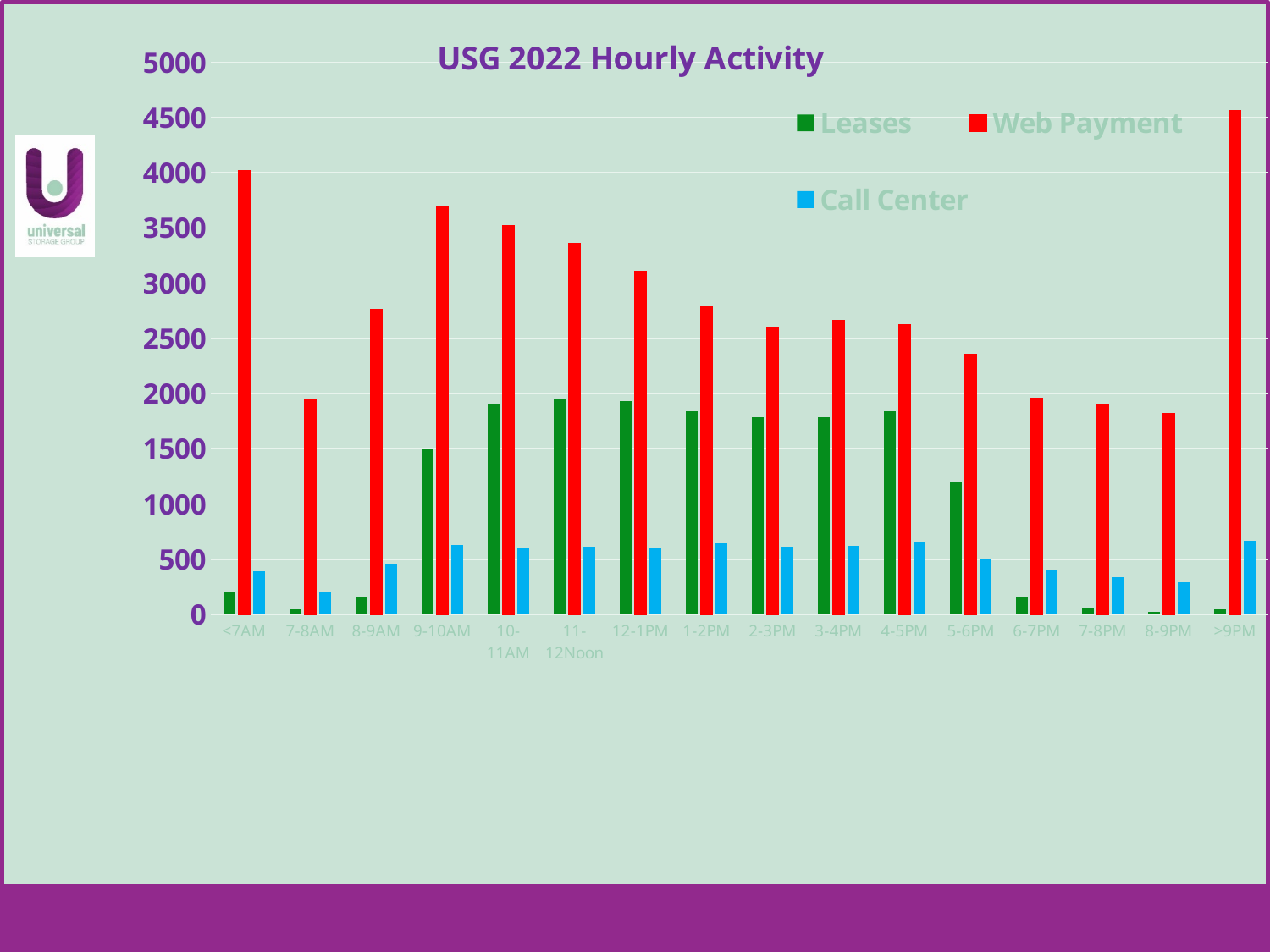
Which is larger, the Web Payment value for 8-9AM or for 12-1PM? 12-1PM Which hourly category has the lowest Call Center value? 7-8AM Which hourly category has the highest Web Payment value? >9PM How many hourly categories are shown on the x axis? 16 Is the Web Payment value for 5-6PM greater or less than 2500? less Is the Web Payment value for 9-10AM greater or less than 3500? greater How many series does the legend list? 3 What is the title of the chart? USG 2022 Hourly Activity What kind of chart is shown on the slide? bar chart Do the Web Payment values generally rise or fall from 9-10AM to 5-6PM? fall Is the Call Center value for <7AM greater or less than 500? less